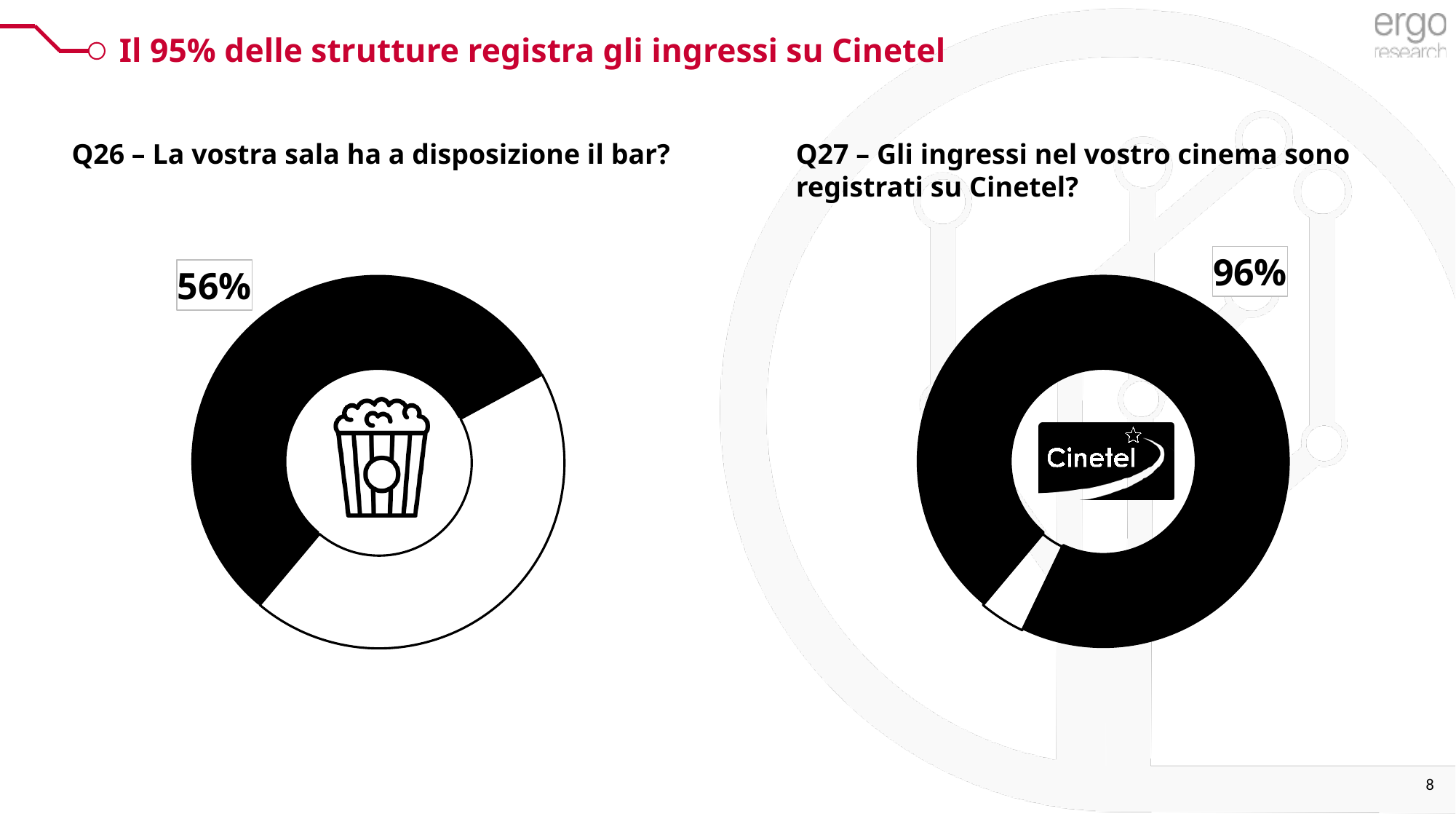
On the right chart (Q27 – Gli ingressi nel vostro cinema sono registrati su Cinetel?), what percentage is shown by the data label? 96% Which chart shows the larger highlighted percentage, the Q26 chart on the left or the Q27 chart on the right? Q27 chart on the right How many slices does each donut chart on the slide have? 2 What is the difference between the percentage labelled on the Q27 chart and the percentage labelled on the Q26 chart? 40 percentage points How many donut charts are shown on the slide? 2 On the right chart (Q27), is the highlighted black share greater or less than 90%? greater What kind of chart is used for Q27 on the right of the slide? Donut (pie) chart What is the title of the slide? Il 95% delle strutture registra gli ingressi su Cinetel On the left chart (Q26 – La vostra sala ha a disposizione il bar?), what percentage is shown by the data label? 56% On the left chart (Q26), is the highlighted black share greater or less than 50%? greater What kind of chart is used for Q26 on the left of the slide? Donut (pie) chart What icon is shown in the centre of the left chart (Q26)? A popcorn box